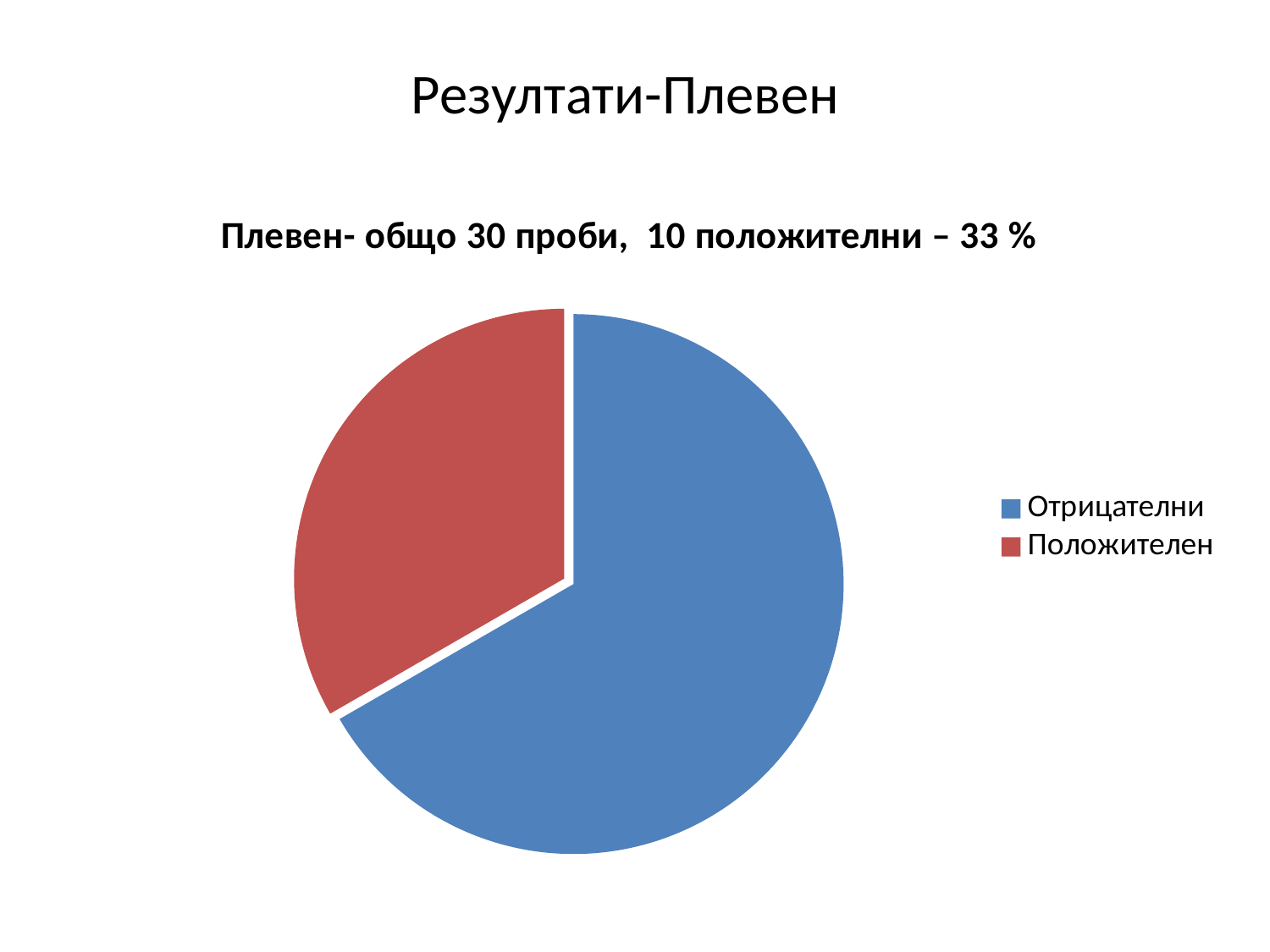
How many entries does the legend of the pie chart list? 2 According to the chart title, how many samples were positive (положителни)? 10 Which slice is larger, Отрицателни or Положителен? Отрицателни Which category takes the largest share of the pie chart? Отрицателни Given 30 samples in total and 10 positive, how many samples were negative (Отрицателни)? 20 Which category takes the smallest share of the pie chart? Положителен What is the title of the pie chart? Плевен- общо 30 проби, 10 положителни – 33 % What share of the pie does the Положителен slice represent, as stated in the chart title? 33 % What kind of chart is shown on the slide? pie chart What colour is the Отрицателни slice in the pie chart? blue According to the chart title, how many samples (проби) were tested in total in Плевен? 30 How many slices does the pie chart have? 2